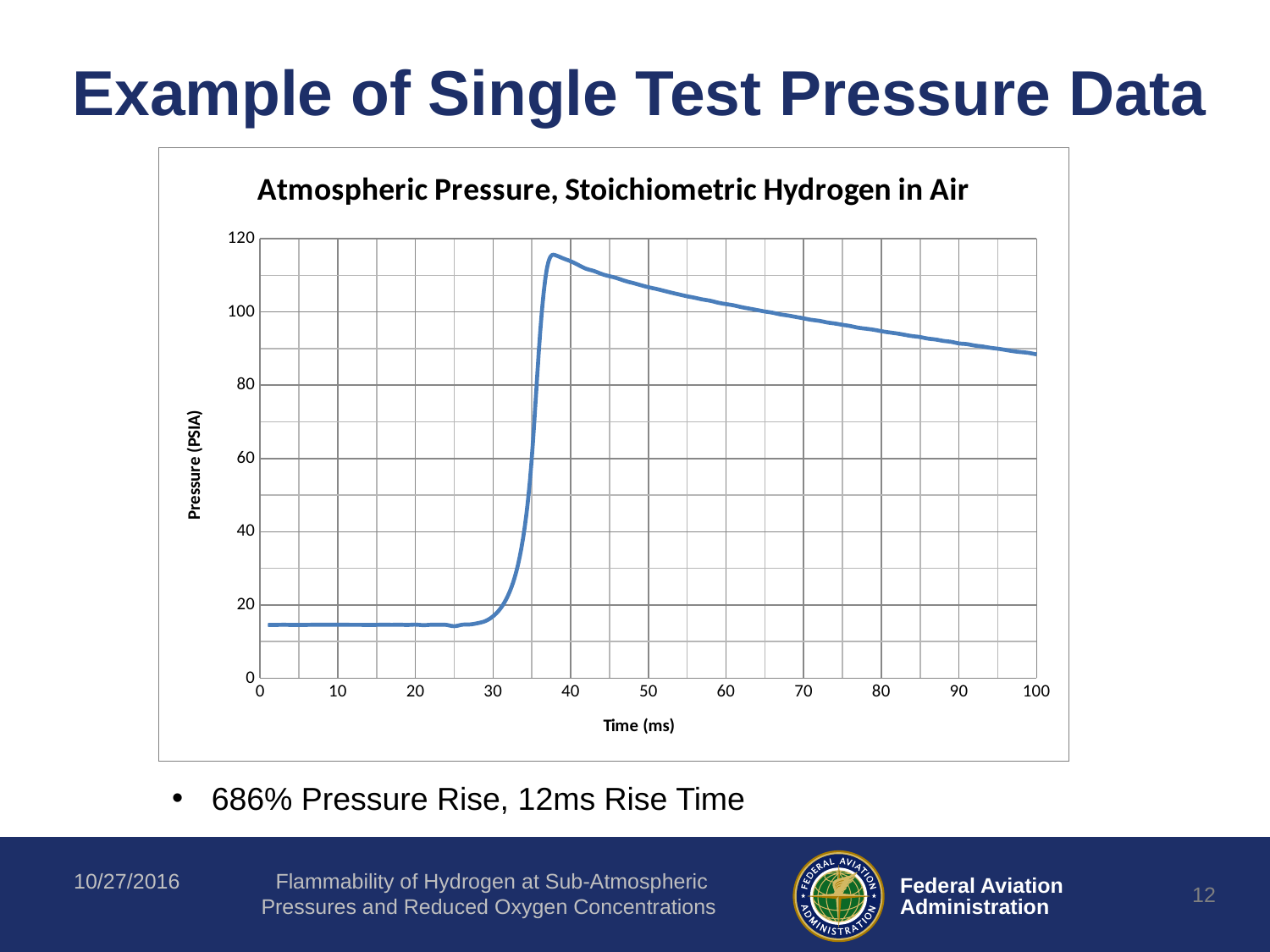
Is the pressure at 10 ms greater or less than 40 PSIA? less Which is larger, the pressure at 40 ms or the pressure at 90 ms? 40 ms What is the title of the chart? Atmospheric Pressure, Stoichiometric Hydrogen in Air Is the pressure at 100 ms greater or less than 100 PSIA? less How many lines are plotted on the chart? 1 What is the label of the vertical axis of the chart? Pressure (PSIA) What kind of chart is shown on the slide? Line chart Is the pressure at 20 ms greater or less than 20 PSIA? less Does the pressure rise or fall between 40 ms and 100 ms? Fall